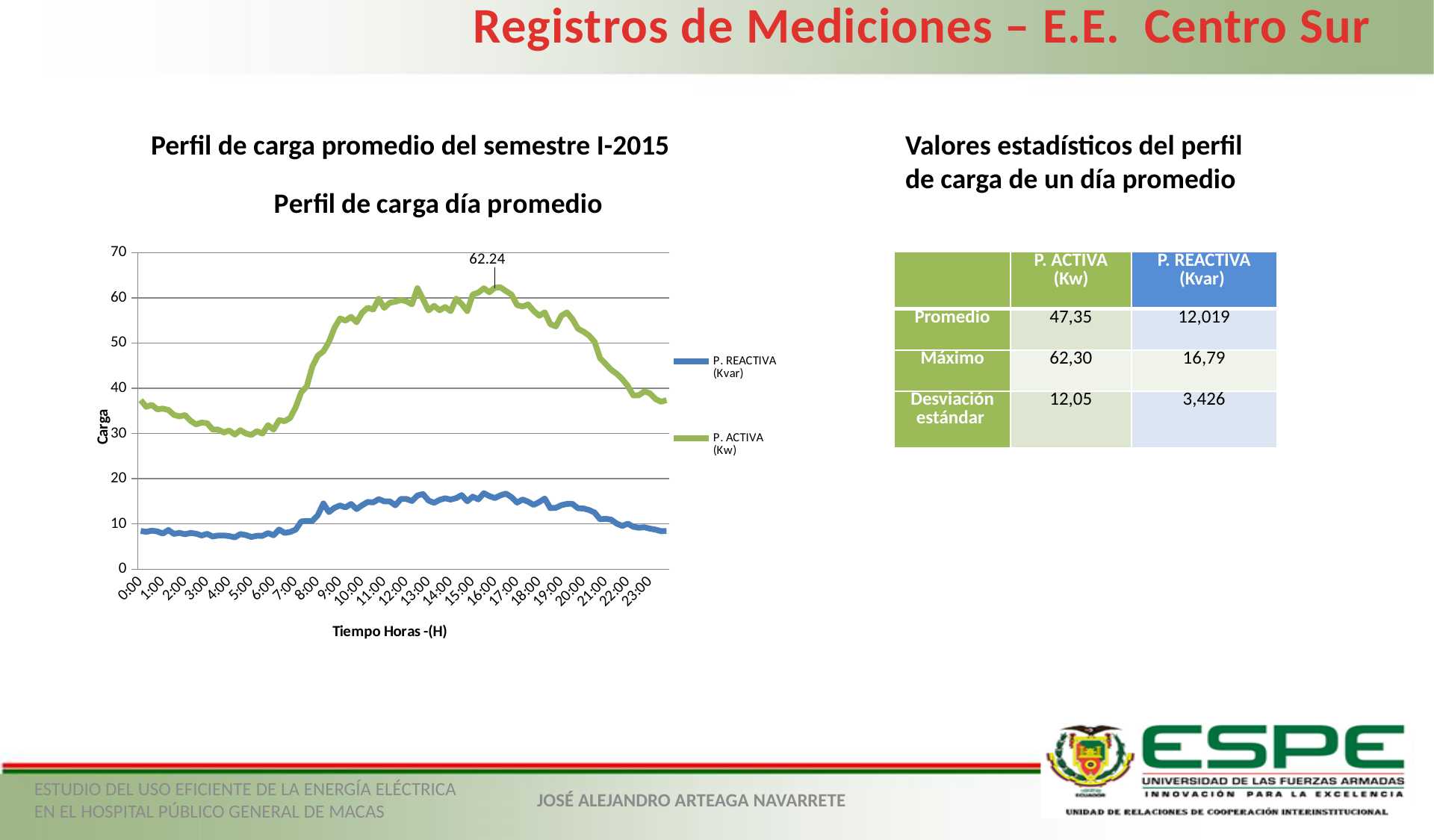
What kind of chart is "Perfil de carga día promedio"? Line chart Which series reaches the highest value in the chart, P. ACTIVA (Kw) or P. REACTIVA (Kvar)? P. ACTIVA (Kw) How many hour labels are shown on the x axis of the chart? 24 Is the value of P. REACTIVA (Kvar) at 16:00 greater or less than 20? less At 12:00, which series has the larger value, P. ACTIVA (Kw) or P. REACTIVA (Kvar)? P. ACTIVA (Kw) How many series does the legend of the chart list? 2 What is the title of the x axis of the chart? Tiempo Horas -(H) Does the P. ACTIVA (Kw) line rise or fall between 6:00 and 12:00? Rise Does the P. ACTIVA (Kw) line rise or fall between 17:00 and 23:00? Fall What is the peak value labelled on the P. ACTIVA (Kw) line in the chart? 62.24 Is the value of P. ACTIVA (Kw) at 10:00 greater or less than 50? greater Is the value of P. REACTIVA (Kvar) at 0:00 greater or less than 10? less